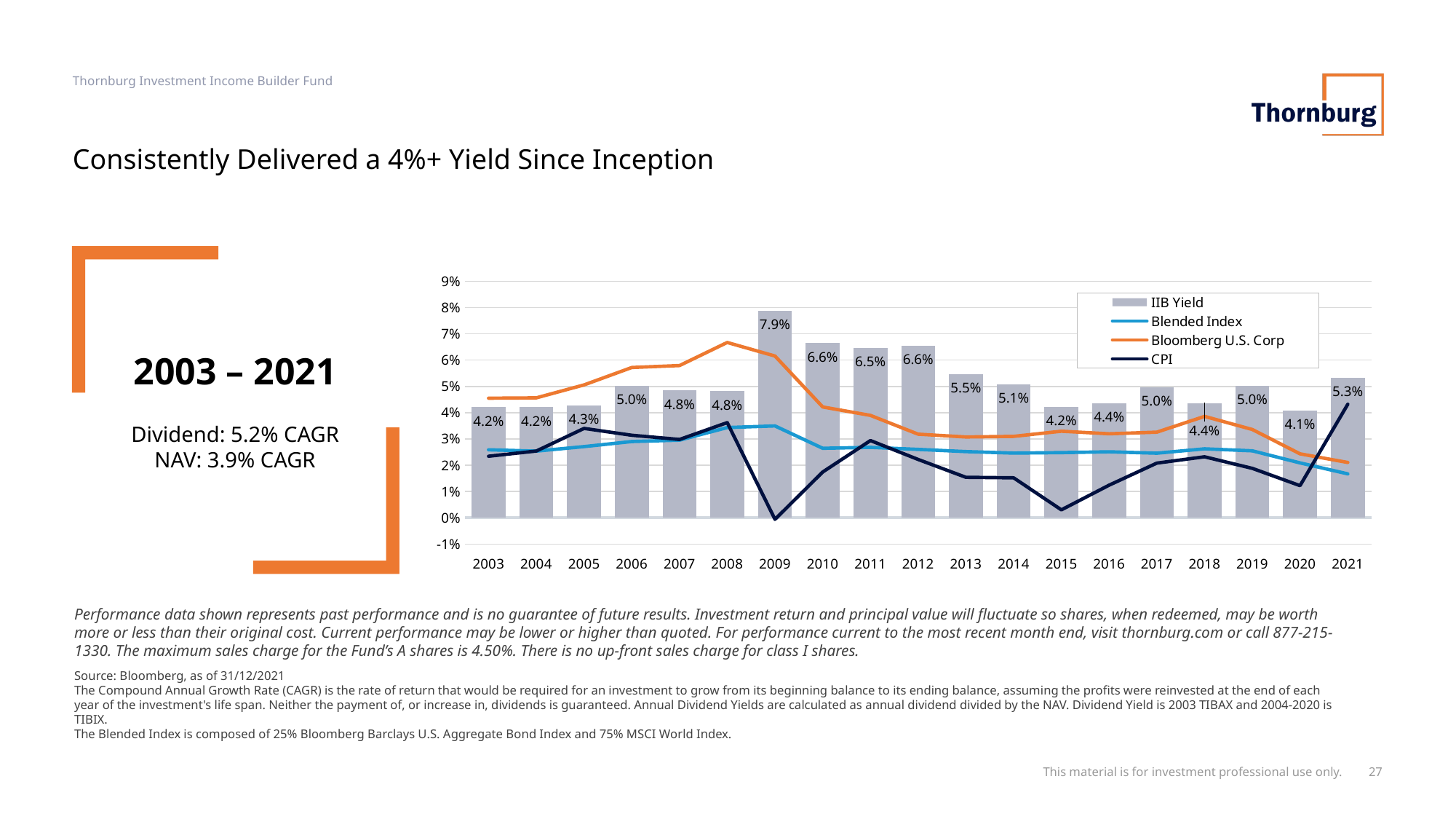
Which is larger, the IIB Yield in 2013 or in 2014? 2013 How many series does the chart legend list? 4 What is the IIB Yield for 2021? 5.3% Is the CPI value for 2009 greater or less than 1%? less What is the IIB Yield for 2015? 4.2% Is the Bloomberg U.S. Corp value for 2008 greater or less than 6%? greater What is the difference between the IIB Yield in 2009 and in 2010? 1.3 percentage points What kind of chart is shown on the slide? Combined bar and line chart What is the IIB Yield for 2009? 7.9% Which year has the highest IIB Yield? 2009 How many years are shown on the x axis of the chart? 19 Which year has the lowest IIB Yield? 2020